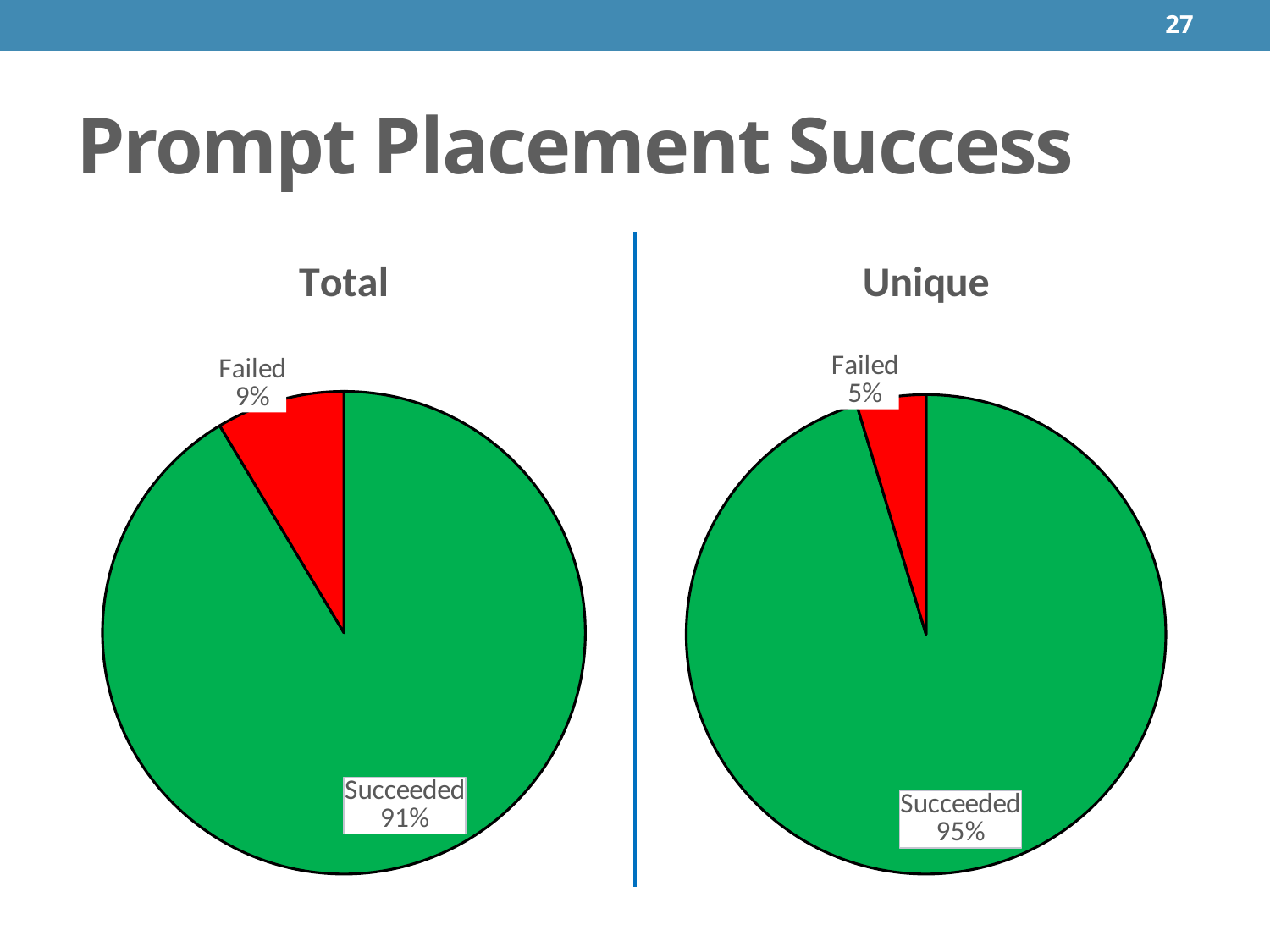
In the "Total" pie chart, what share is labelled Succeeded? 91% Which chart has the larger Failed share, "Total" or "Unique"? Total In the "Total" pie chart, what share is labelled Failed? 9% In the "Total" pie chart, what is the difference between the Succeeded and Failed shares? 82% What is the difference between the Succeeded share in the "Unique" chart and the Succeeded share in the "Total" chart? 4% What colour is the Failed slice in the "Unique" pie chart? Red In the "Unique" pie chart, what share is labelled Failed? 5% How many slices does the "Unique" pie chart have? 2 In the "Unique" pie chart, what share is labelled Succeeded? 95% In the "Total" pie chart, which slice is the largest? Succeeded In the "Unique" pie chart, which slice is the smallest? Failed What kind of chart is the "Total" chart? Pie chart